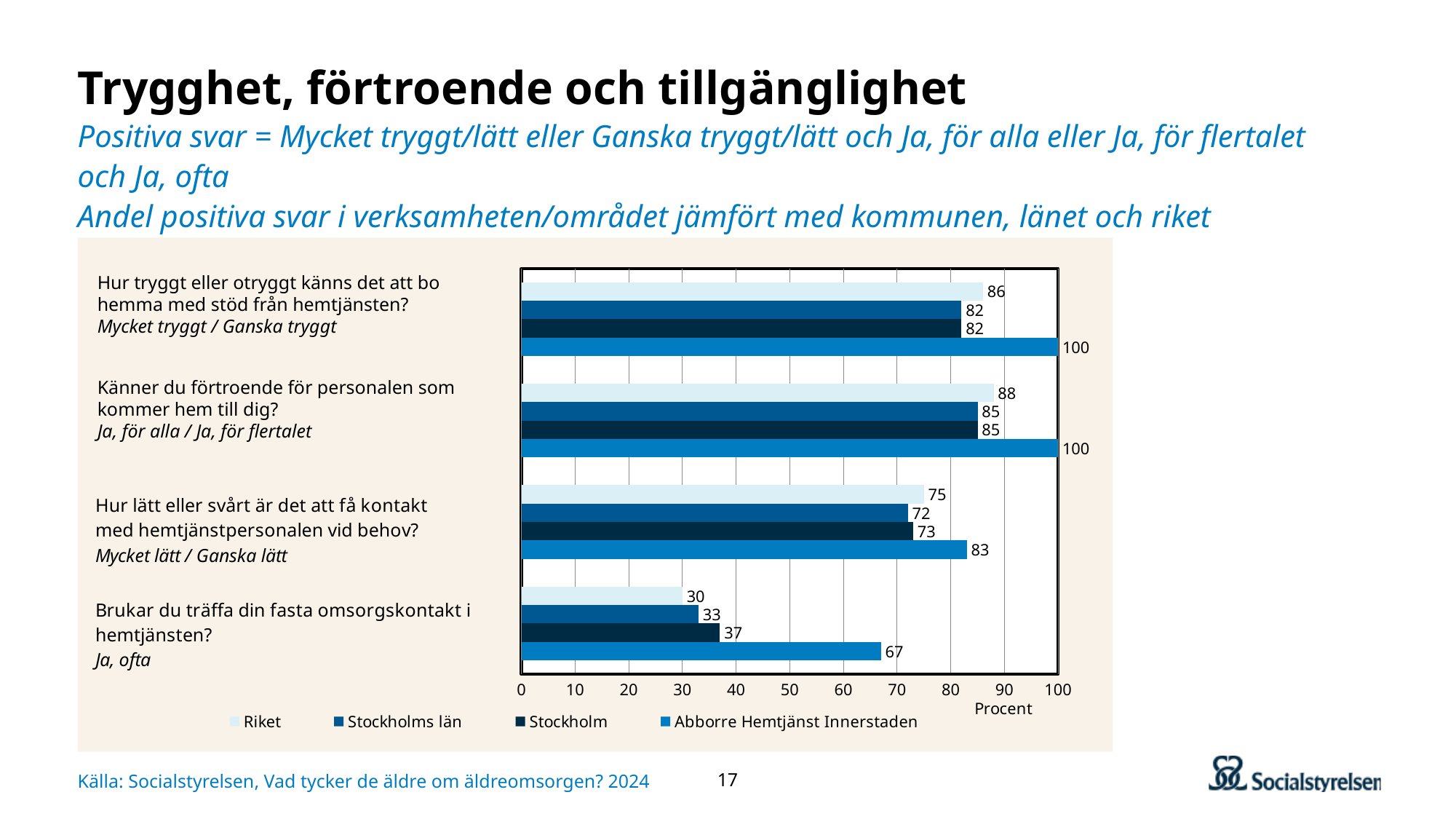
What is the difference between Abborre Hemtjänst Innerstaden and Riket for the question 'Brukar du träffa din fasta omsorgskontakt i hemtjänsten?' 37 What is the value for Riket for the question 'Känner du förtroende för personalen som kommer hem till dig?' 88 How many question categories are plotted on the chart? 4 How many series does the legend list? 4 What is the value for Abborre Hemtjänst Innerstaden for the question 'Hur tryggt eller otryggt känns det att bo hemma med stöd från hemtjänsten?' 100 What is the label on the horizontal axis of the chart? Procent What is the value for Stockholm for the question 'Brukar du träffa din fasta omsorgskontakt i hemtjänsten?' 37 Which series has the highest value for the question 'Hur lätt eller svårt är det att få kontakt med hemtjänstpersonalen vid behov?' Abborre Hemtjänst Innerstaden What is the value for Stockholms län for the question 'Hur lätt eller svårt är det att få kontakt med hemtjänstpersonalen vid behov?' 72 For the question 'Hur tryggt eller otryggt känns det att bo hemma med stöd från hemtjänsten?', which is larger: Riket or Stockholm? Riket Which series has the lowest value for the question 'Brukar du träffa din fasta omsorgskontakt i hemtjänsten?' Riket What kind of chart is shown on the slide? bar chart